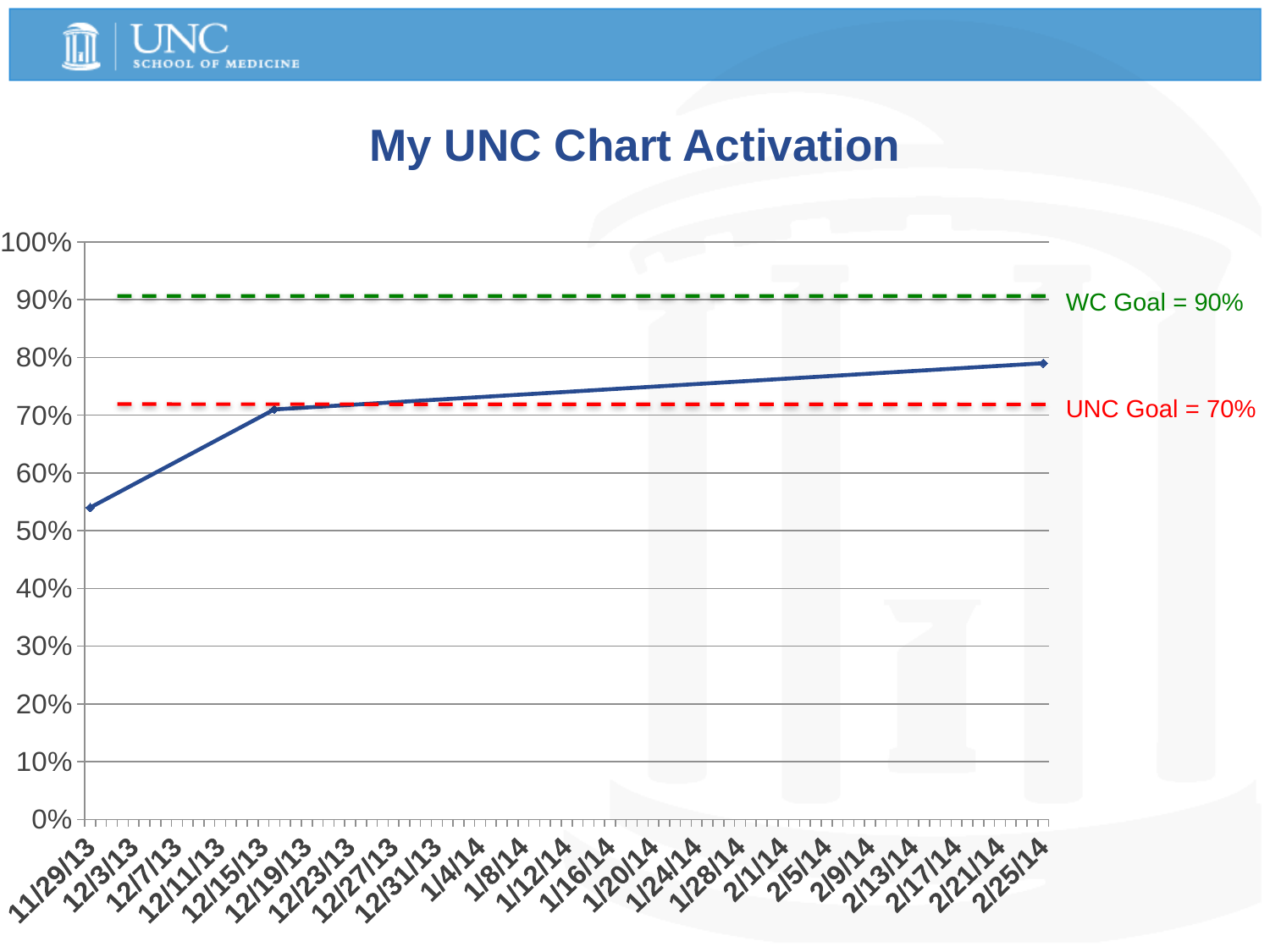
What colour is the dashed line marking the WC Goal? green What kind of chart is shown on the slide? line chart Is the activation value at 2/25/14 greater or less than the WC Goal of 90%? less Which date has the highest activation value on the blue line? 2/25/14 Is the activation value at 11/29/13 greater or less than 60%? less What value is the WC Goal line set at? 90% What value is the UNC Goal line set at? 70% What is the title of the chart? My UNC Chart Activation Is the activation value at 2/25/14 greater or less than 70%? greater Does the activation line rise or fall from 11/29/13 to 2/25/14? rise